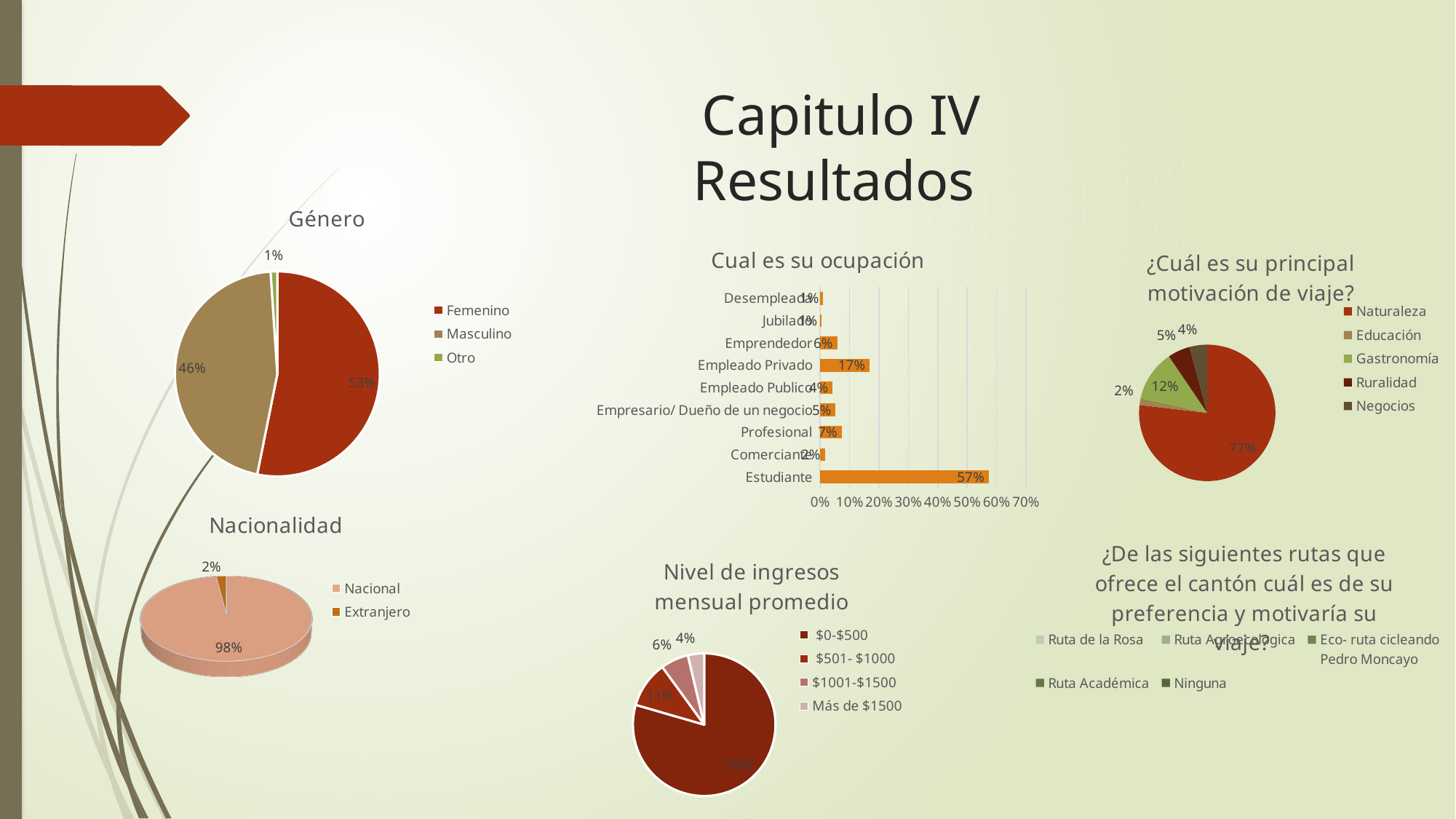
In the 'Nivel de ingresos mensual promedio' chart, what percentage is $501-$1000? 11% In the 'Cual es su ocupación' chart, which category has the highest value? Estudiante In the 'Género' chart, which category has the smallest share? Otro In the 'Cual es su ocupación' chart, what is the difference between Empleado Privado and Profesional? 10% In the 'Género' chart, what percentage is Femenino? 53% In the '¿Cuál es su principal motivación de viaje?' chart, what percentage is Naturaleza? 77% What kind of chart is 'Cual es su ocupación'? Bar chart In the '¿Cuál es su principal motivación de viaje?' chart, which is larger, Gastronomía or Ruralidad? Gastronomía In the 'Nacionalidad' chart, what percentage is Extranjero? 2% In the 'Cual es su ocupación' chart, what is the value for Estudiante? 57% How many entries does the legend of the '¿De las siguientes rutas que ofrece el cantón...' chart list? 5 In the 'Cual es su ocupación' chart, how many occupation categories are shown? 9